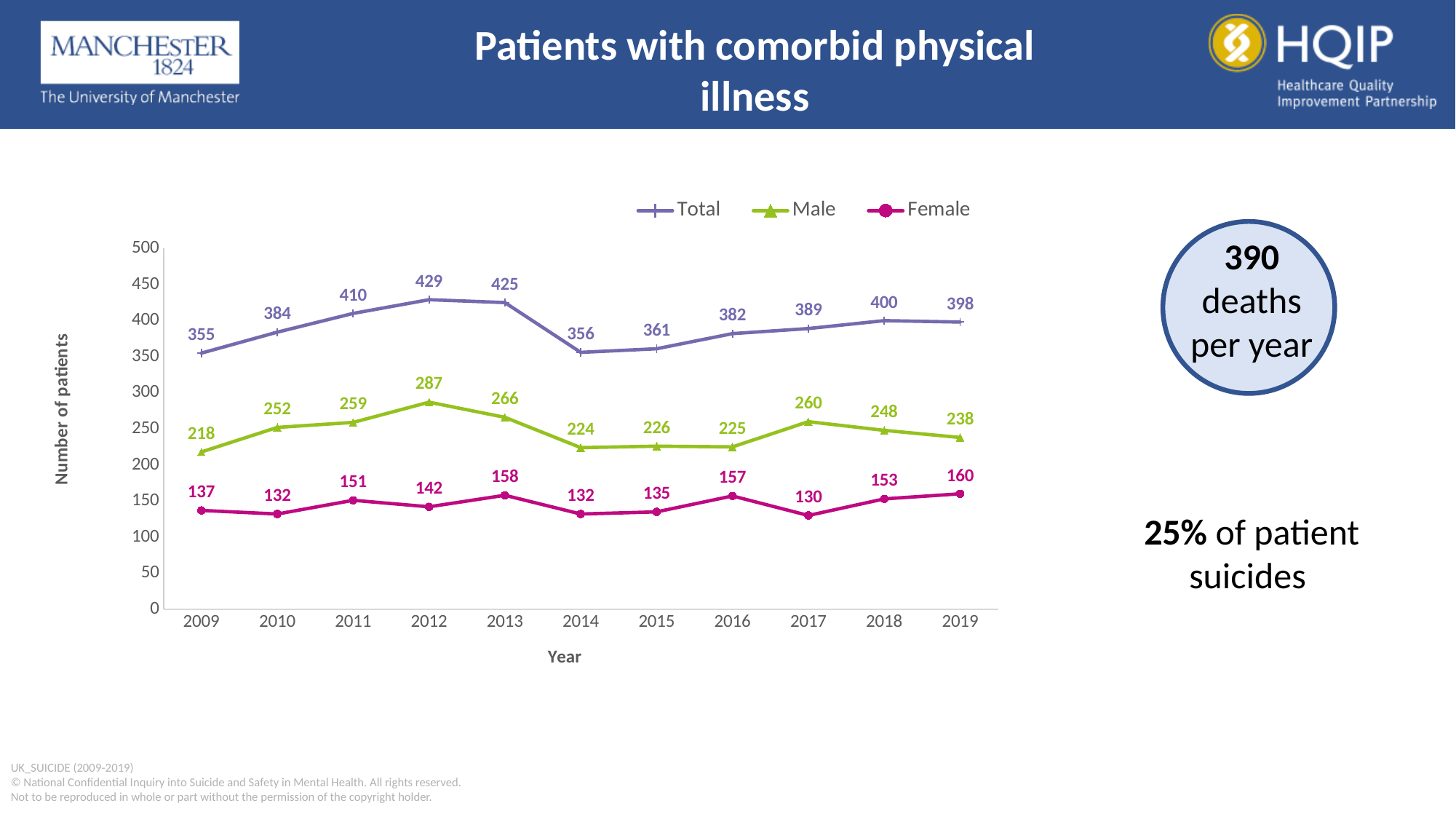
Which is larger, the Total value for 2010 or the Total value for 2015? 2010 What is the label of the y axis? Number of patients What is the Total value for 2012? 429 What is the difference between the Male and Female values in 2013? 108 In which year is the Total series highest? 2012 Does the Total series rise or fall from 2013 to 2014? Fall How many years are shown on the x axis? 11 How many series does the legend list? 3 What is the Male value for 2017? 260 In which year is the Female series lowest? 2017 What is the Female value for 2019? 160 What kind of chart is shown on the slide? Line chart